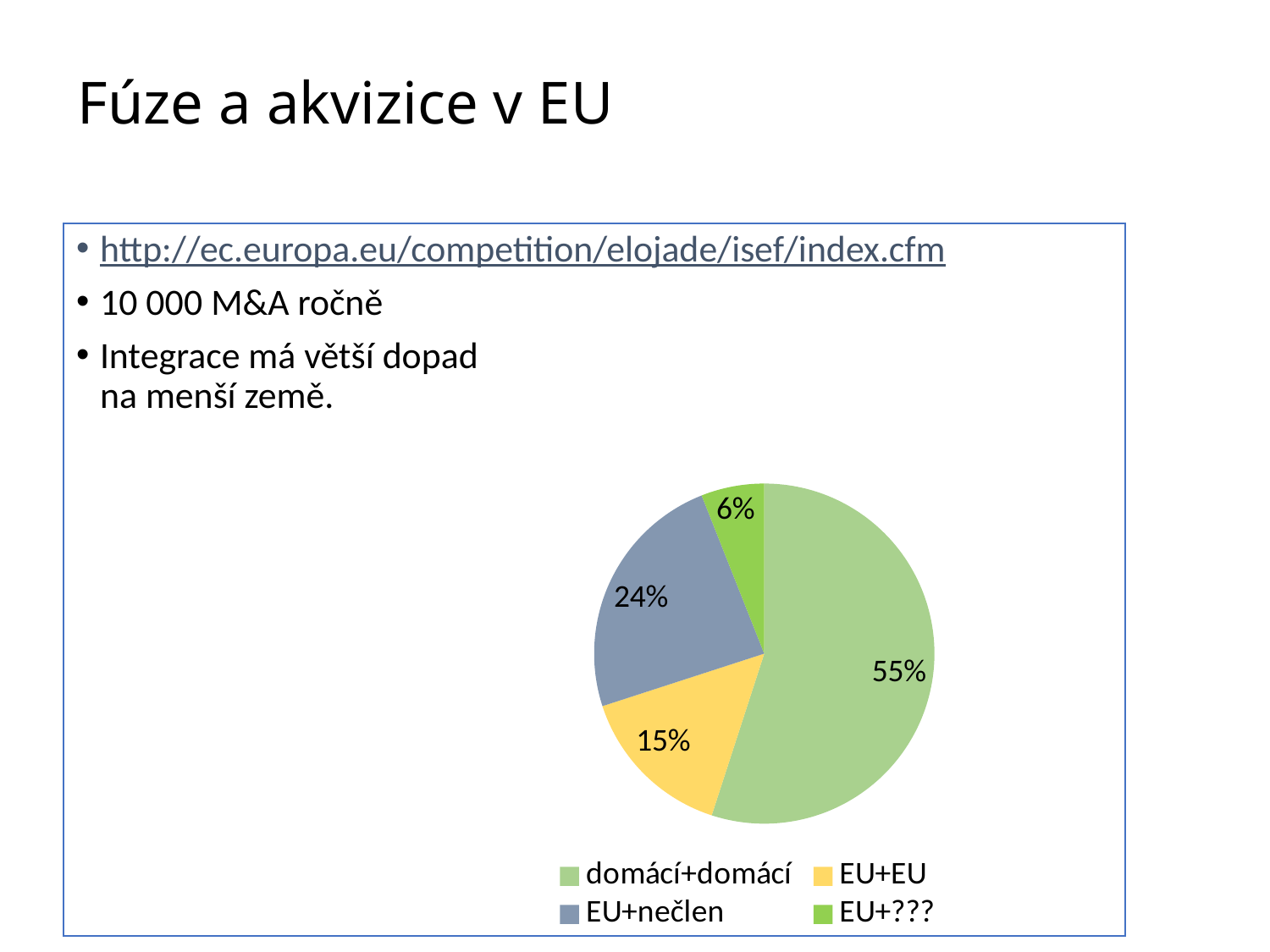
What colour is the slice for EU+EU? yellow What share of the pie does domácí+domácí have? 55% How many entries does the legend list? 4 Which is larger, EU+EU or EU+nečlen? EU+nečlen What share of the pie does EU+nečlen have? 24% What is the difference in percentage points between domácí+domácí and EU+nečlen? 31 What share of the pie does EU+??? have? 6% Which category has the smallest slice of the pie? EU+??? What kind of chart is shown on the slide? pie chart How many slices does the pie chart have? 4 Which category has the largest slice of the pie? domácí+domácí What share of the pie does EU+EU have? 15%